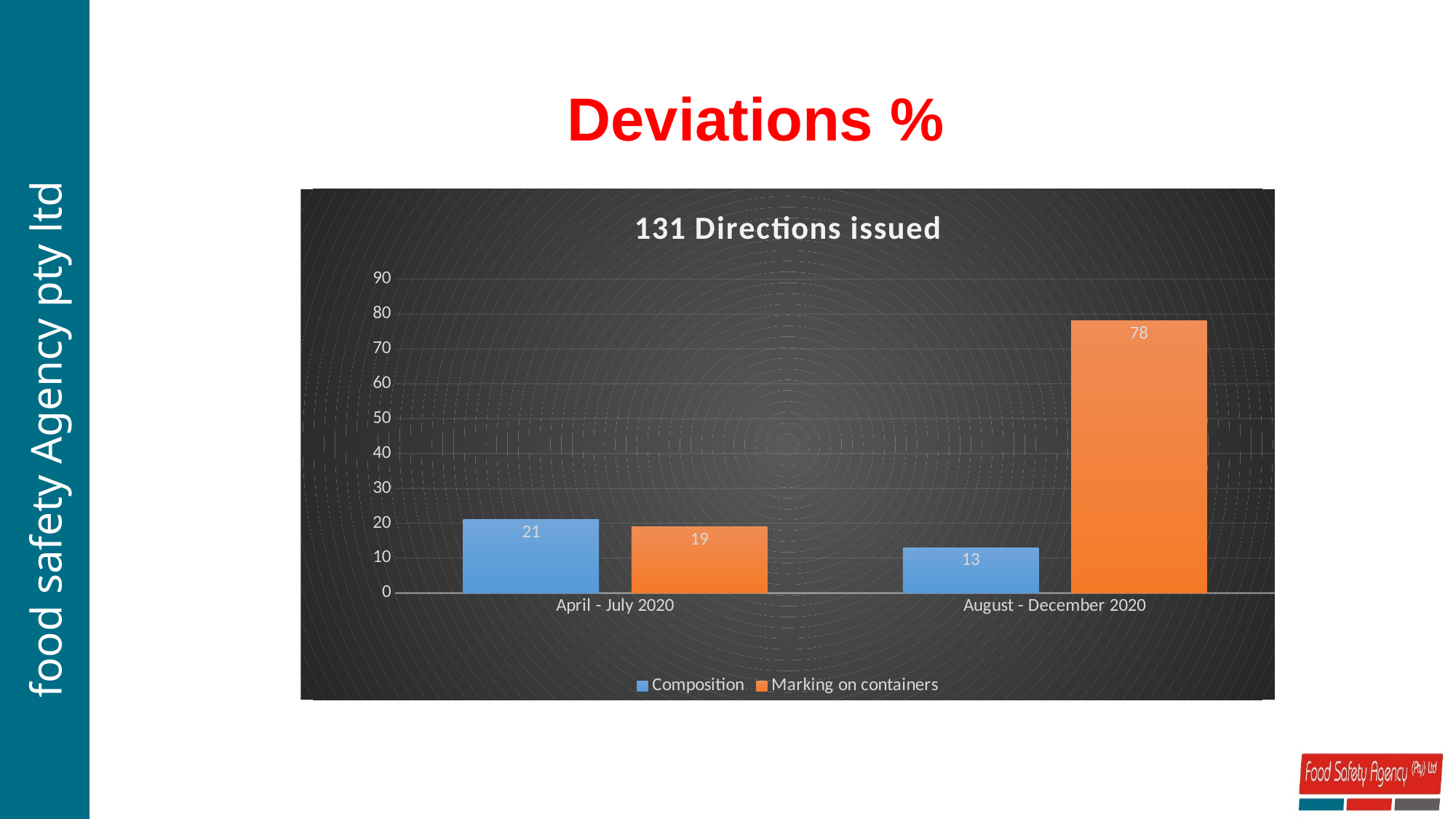
What is the value for Composition in August - December 2020? 13 What is the title of the chart? 131 Directions issued Which bar has the lowest value on the chart? Composition in August - December 2020 Which series has the highest value in August - December 2020? Marking on containers How many categories are shown on the x axis? 2 What is the value for Composition in April - July 2020? 21 What is the difference between Marking on containers and Composition in August - December 2020? 65 Which is larger in April - July 2020: Composition or Marking on containers? Composition What is the value for Marking on containers in April - July 2020? 19 What is the value for Marking on containers in August - December 2020? 78 What kind of chart is shown on the slide? Bar chart How many series does the legend list? 2